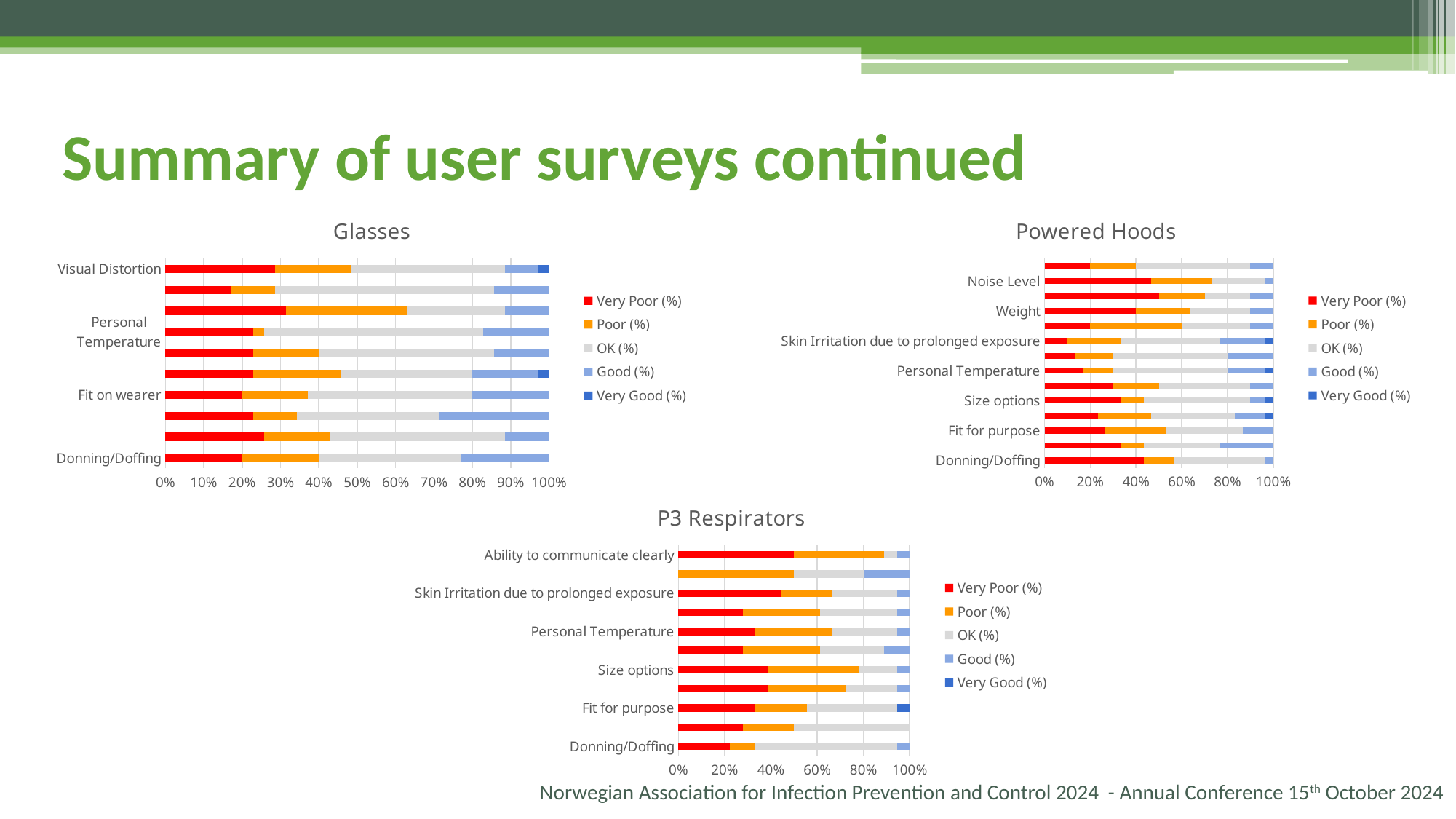
What kind of chart is the Glasses chart? Stacked bar chart In the Powered Hoods chart, which has the larger Very Poor (%) segment: Donning/Doffing or Skin Irritation due to prolonged exposure? Donning/Doffing In the P3 Respirators chart, is the combined Very Poor (%) and Poor (%) share for Ability to communicate clearly greater or less than 80%? greater In the Glasses chart, is the Very Poor (%) value for Visual Distortion greater or less than 50%? less In the P3 Respirators chart, which has the larger Very Poor (%) segment: Ability to communicate clearly or Donning/Doffing? Ability to communicate clearly What is the title of the chart at the bottom of the slide? P3 Respirators In the Powered Hoods chart, is the Very Poor (%) value for Size options greater or less than 20%? greater In the P3 Respirators chart, which colour represents the Very Poor (%) series? Red In the Glasses chart, which has the larger Very Poor (%) segment: Visual Distortion or Donning/Doffing? Visual Distortion How many series does the legend of the Powered Hoods chart list? 5